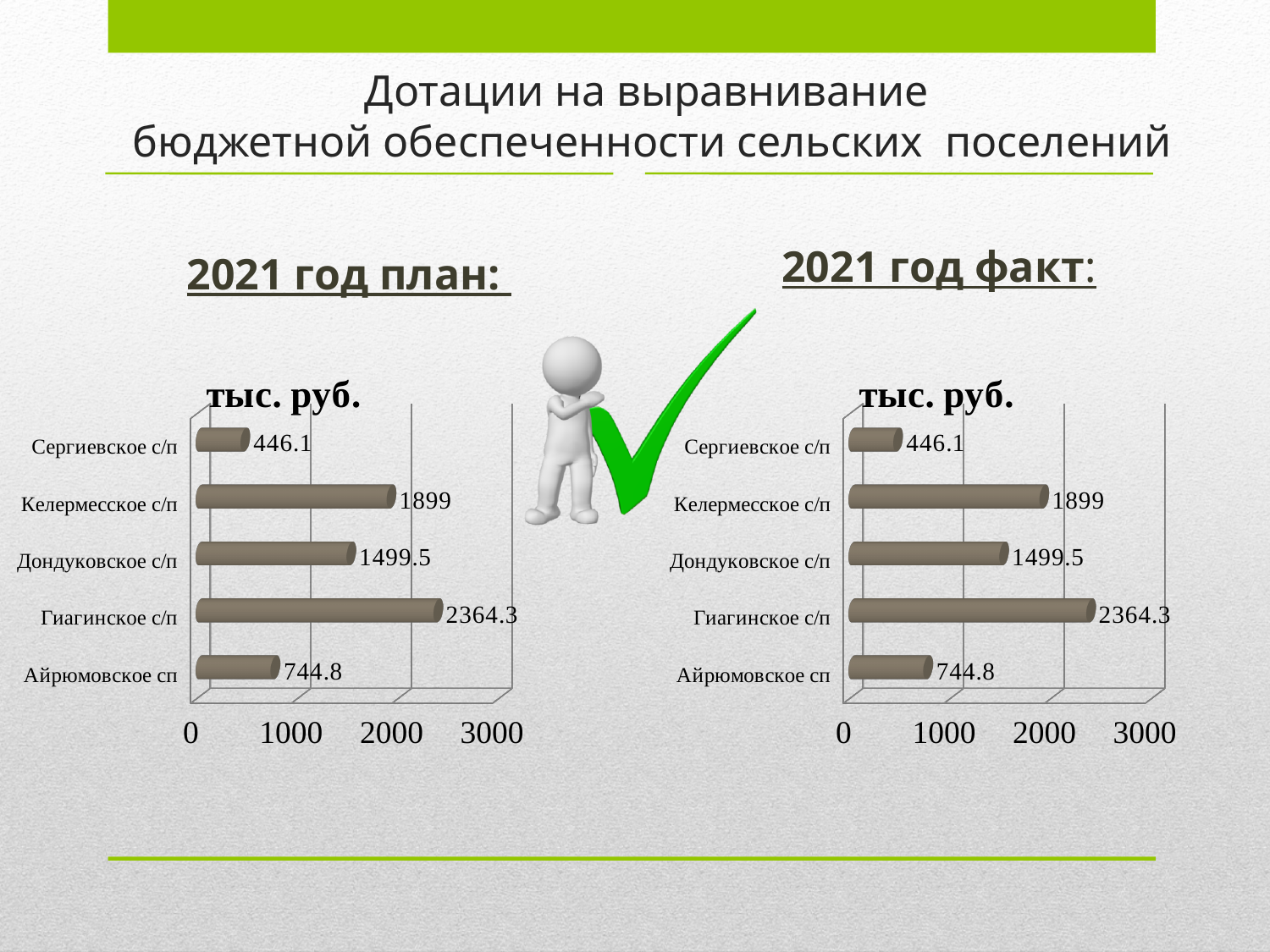
In the right chart (2021 год факт), what is the value for Айрюмовское сп? 744.8 In the left chart (2021 год план), what is the value for Гиагинское с/п? 2364.3 In the right chart (2021 год факт), what is the value for Келермесское с/п? 1899 What type of chart is the left chart (2021 год план)? bar chart In the left chart (2021 год план), what is the difference between Гиагинское с/п and Дондуковское с/п? 864.8 In the left chart (2021 год план), is the value for Дондуковское с/п greater or less than 1000? greater How many categories are shown in the right chart (2021 год факт)? 5 In the right chart (2021 год факт), which category has the lowest value? Сергиевское с/п In the left chart (2021 год план), what is the value for Сергиевское с/п? 446.1 What unit is given in the title of the right chart (2021 год факт)? тыс. руб. In the right chart (2021 год факт), which is larger: Келермесское с/п or Айрюмовское сп? Келермесское с/п In the left chart (2021 год план), which category has the highest value? Гиагинское с/п